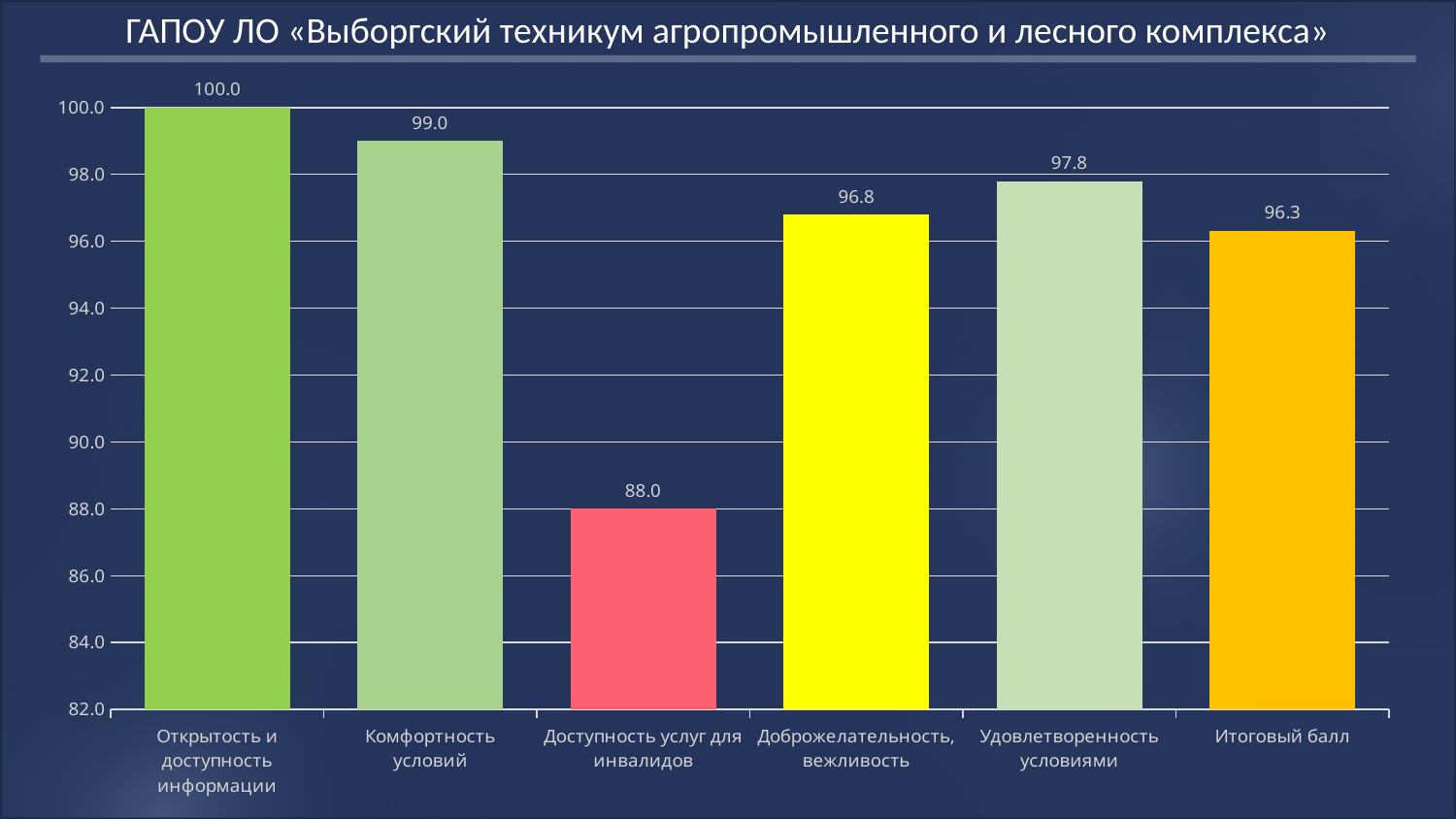
Which category has the highest value? Открытость и доступность информации What kind of chart is shown on the slide? bar chart What is the value for «Доступность услуг для инвалидов»? 88.0 Which is larger: the value for «Доброжелательность, вежливость» or the value for «Итоговый балл»? Доброжелательность, вежливость What is the value for «Открытость и доступность информации»? 100.0 What is the difference between the values for «Удовлетворенность условиями» and «Доброжелательность, вежливость»? 1.0 What is the value for «Удовлетворенность условиями»? 97.8 How many categories are shown on the chart? 6 Which category has the lowest value? Доступность услуг для инвалидов What is the difference between the values for «Комфортность условий» and «Доступность услуг для инвалидов»? 11.0 Is the value for «Доступность услуг для инвалидов» greater or less than 90.0? less What is the value for «Итоговый балл»? 96.3